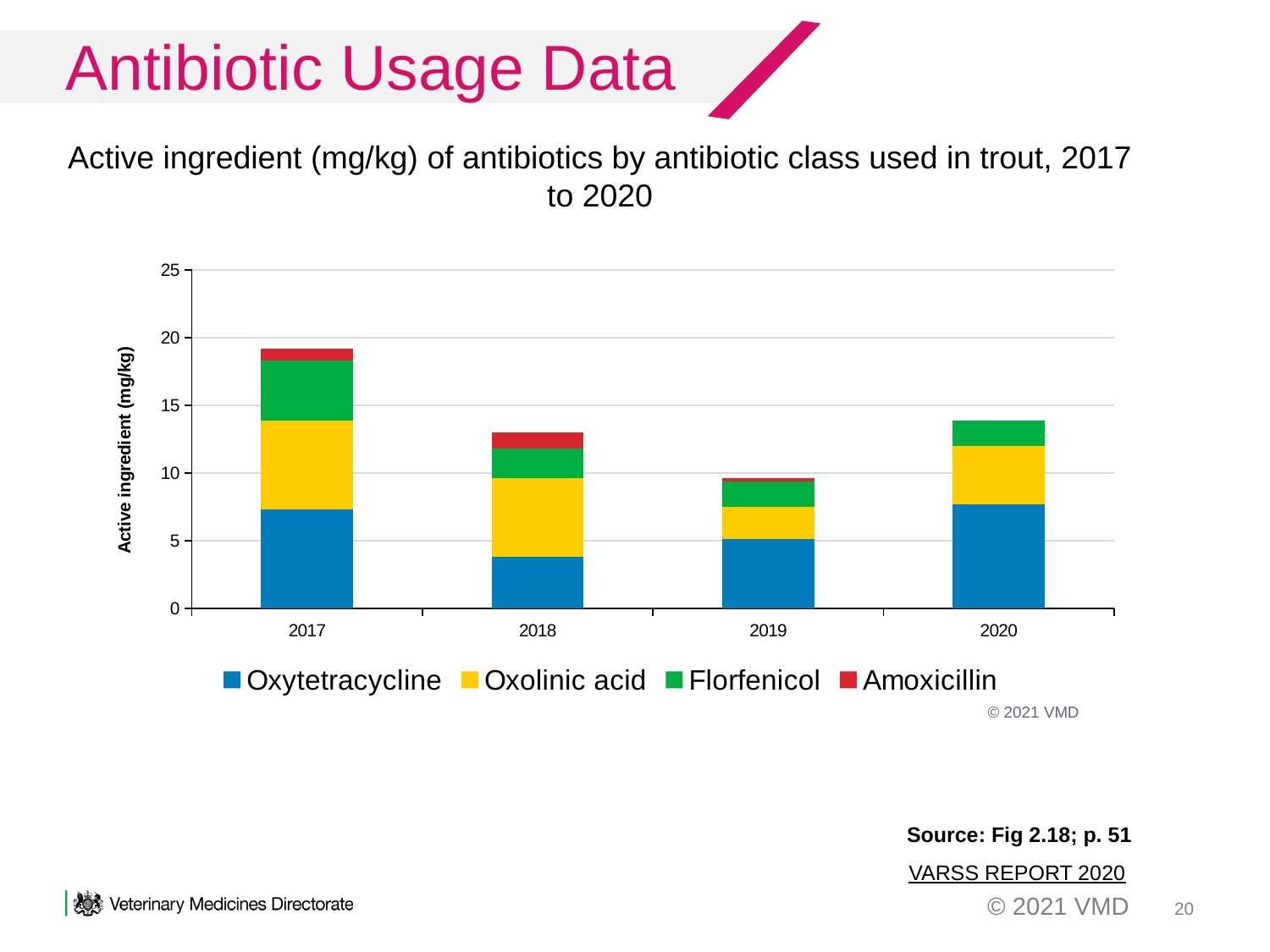
Is the total active ingredient for 2019 greater or less than 10 mg/kg? less Which antibiotic class is represented by the red segments in the chart? Amoxicillin How many antibiotic classes does the legend list? 4 Does the total active ingredient rise or fall from 2017 to 2019? fall Is the total active ingredient for 2020 greater or less than 15 mg/kg? less Which year has the larger total active ingredient, 2017 or 2019? 2017 What kind of chart is shown on the slide? Stacked bar chart Is the total active ingredient for 2017 greater or less than 15 mg/kg? greater Which year has the lowest total active ingredient (mg/kg)? 2019 How many years are shown on the x axis of the chart? 4 Which year has the highest total active ingredient (mg/kg)? 2017